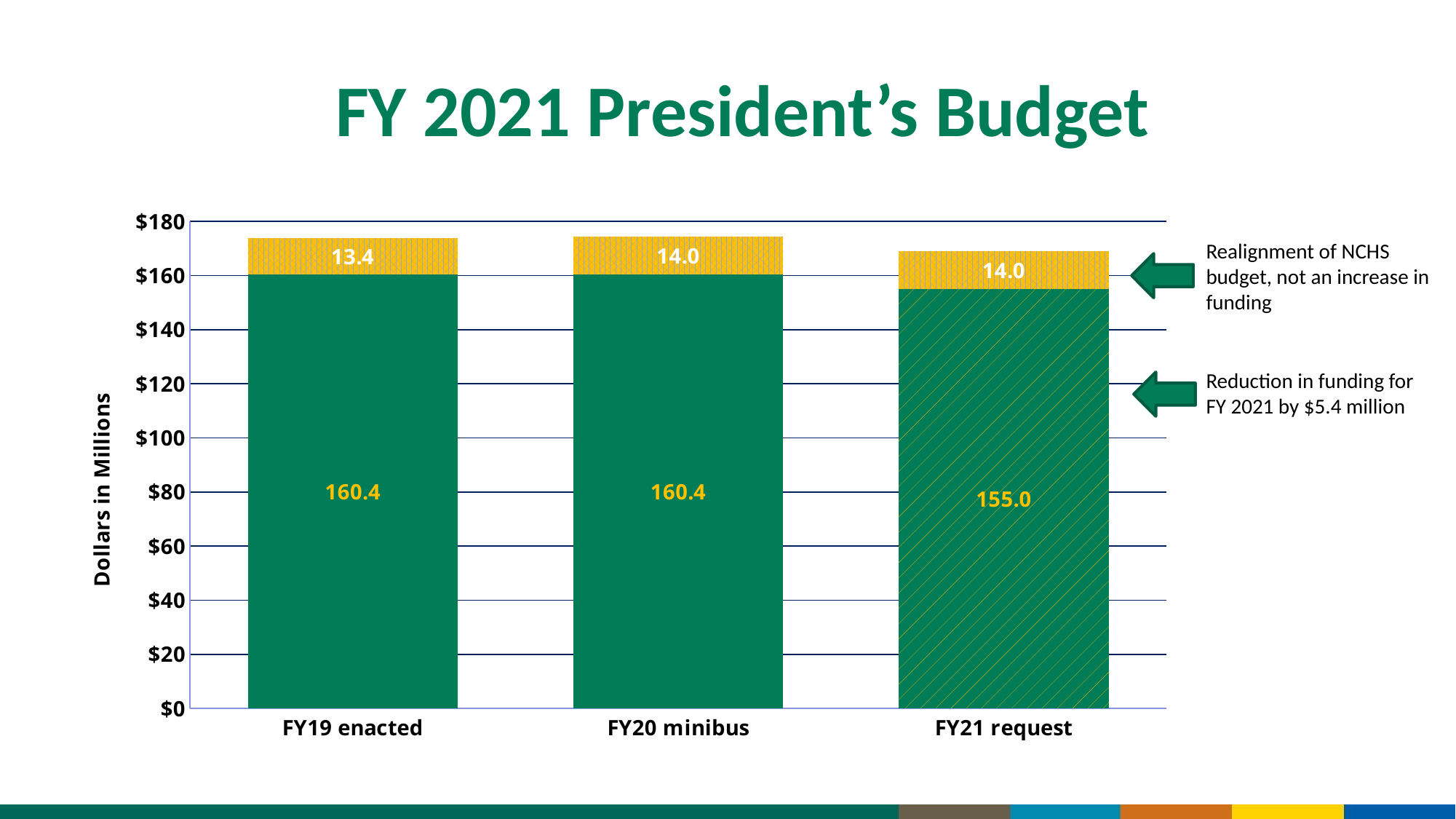
What is the value of the green segment for FY21 request? 155.0 What is the value of the yellow segment for FY21 request? 14.0 How many categories are shown on the x axis? 3 Which category has the lowest green segment value? FY21 request What is the total of the stacked bar for FY21 request? 169.0 What is the value of the green segment for FY20 minibus? 160.4 What is the value of the yellow segment for FY19 enacted? 13.4 Which category has the lowest yellow segment value? FY19 enacted What is the total of the stacked bar for FY19 enacted? 173.8 What is the difference between the green segment values for FY20 minibus and FY21 request? 5.4 What kind of chart is shown on the slide? Stacked bar chart Is the green segment value for FY21 request greater or less than 160? less